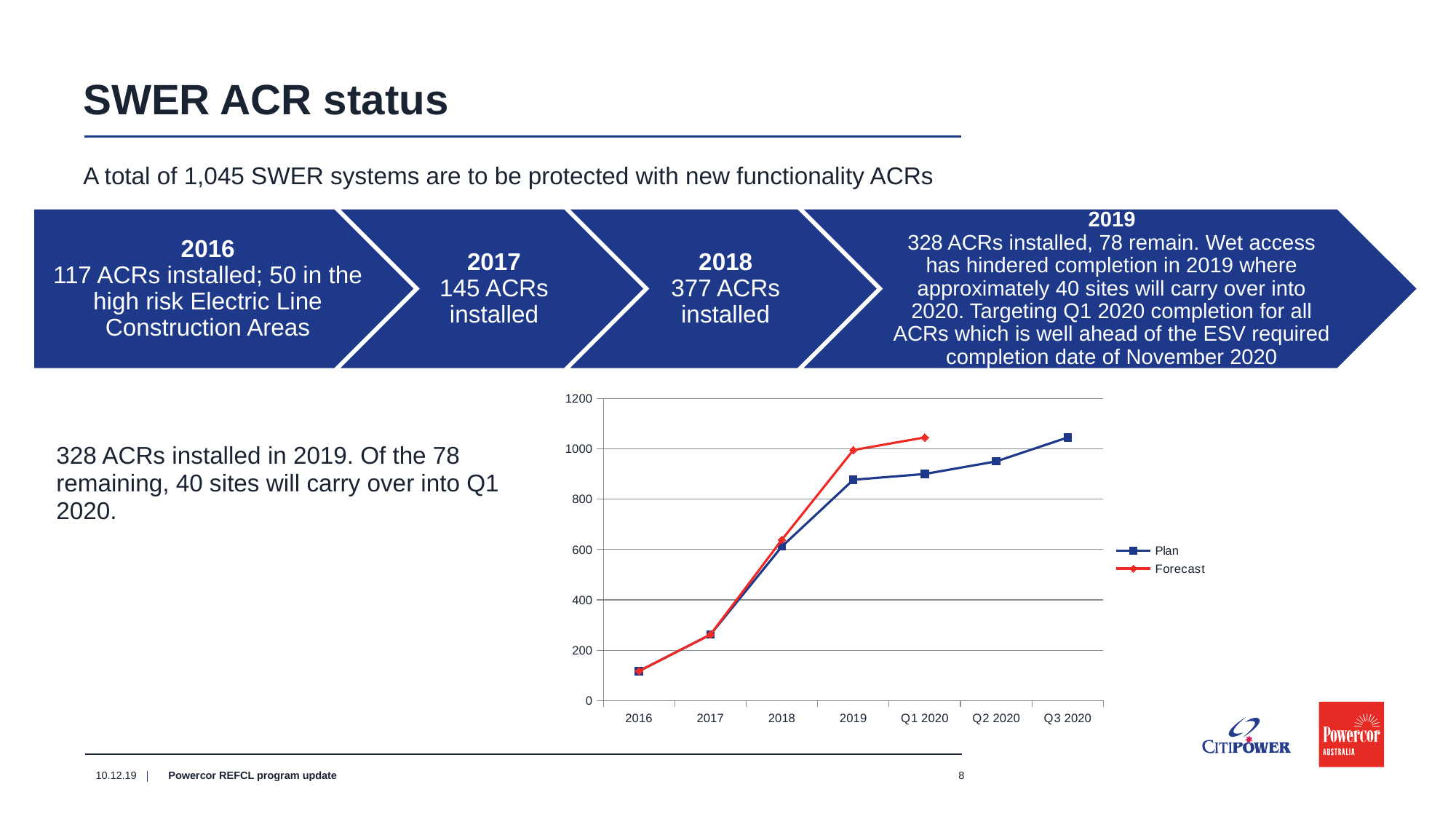
What kind of chart is shown on the slide? line chart At 2019, which series has the larger value, Plan or Forecast? Forecast Is the Forecast value for 2019 greater or less than 800? greater Is the Plan value for Q1 2020 greater or less than 1000? less Is the Plan value for 2016 greater or less than 200? less At which x-axis category does the Plan series have its lowest value? 2016 How many categories are shown on the x axis of the chart? 7 At which x-axis category does the Plan series reach its highest value? Q3 2020 Does the Plan series rise or fall from 2016 to Q3 2020? rise What are the names of the series in the chart legend? Plan and Forecast How many series does the chart legend list? 2